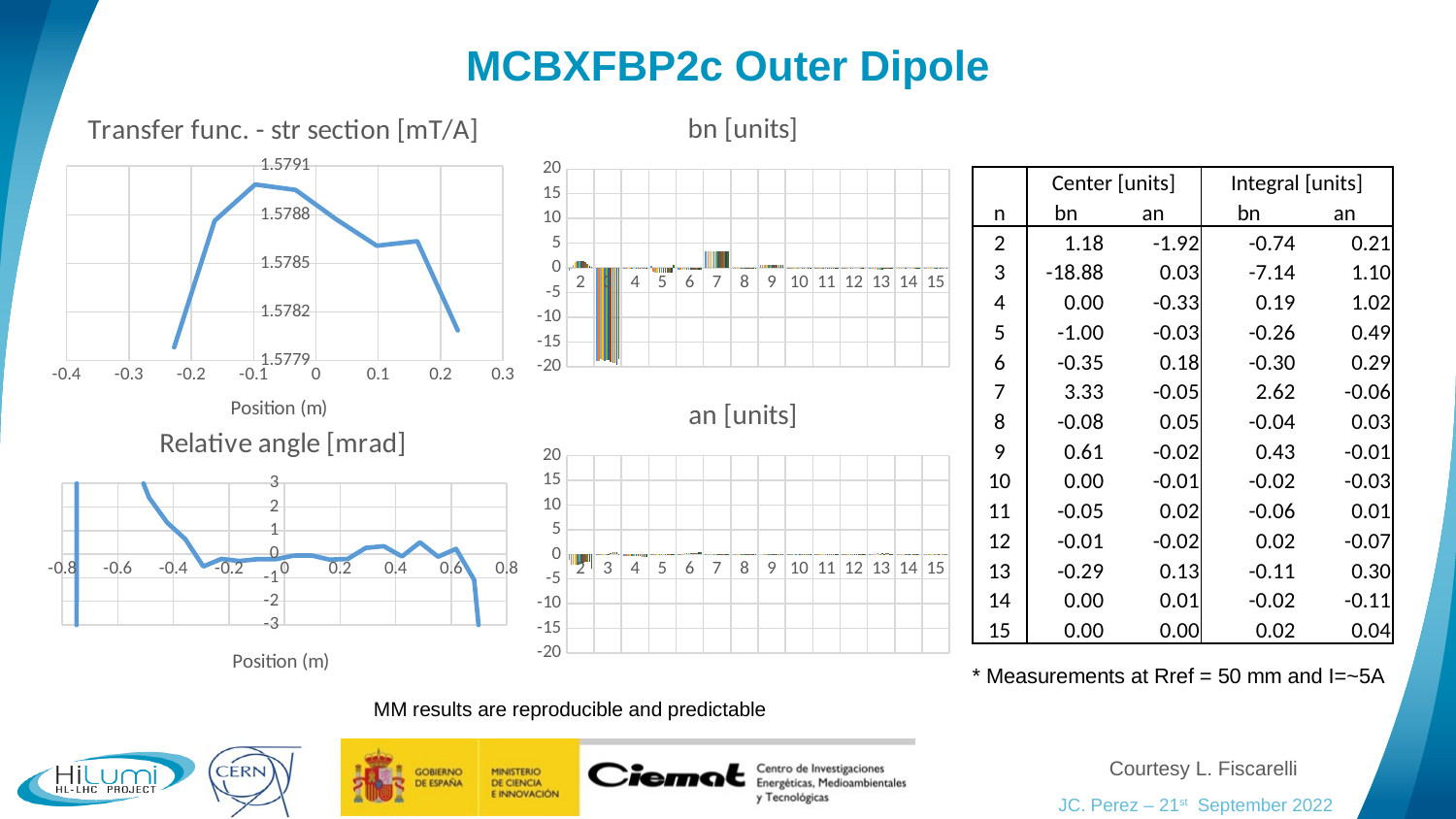
In the "bn [units]" chart, is the value for category 3 greater or less than -10? less In the "Transfer func. - str section [mT/A]" chart, do the values rise or fall along the x axis from 0.1 to 0.3? fall In the "bn [units]" chart, how many categories are shown on the x axis? 14 What kind of chart is the "bn [units]" chart? bar chart What kind of chart is the "an [units]" chart? bar chart In the "an [units]" chart, how many categories are shown on the x axis? 14 What kind of chart is the "Relative angle [mrad]" chart? line chart How many charts are shown on the slide? 4 In the "bn [units]" chart, which category has the lowest value? 3 In the "Transfer func. - str section [mT/A]" chart, is the peak value greater or less than 1.5788? greater What is the x-axis label of the "Relative angle [mrad]" chart? Position (m)